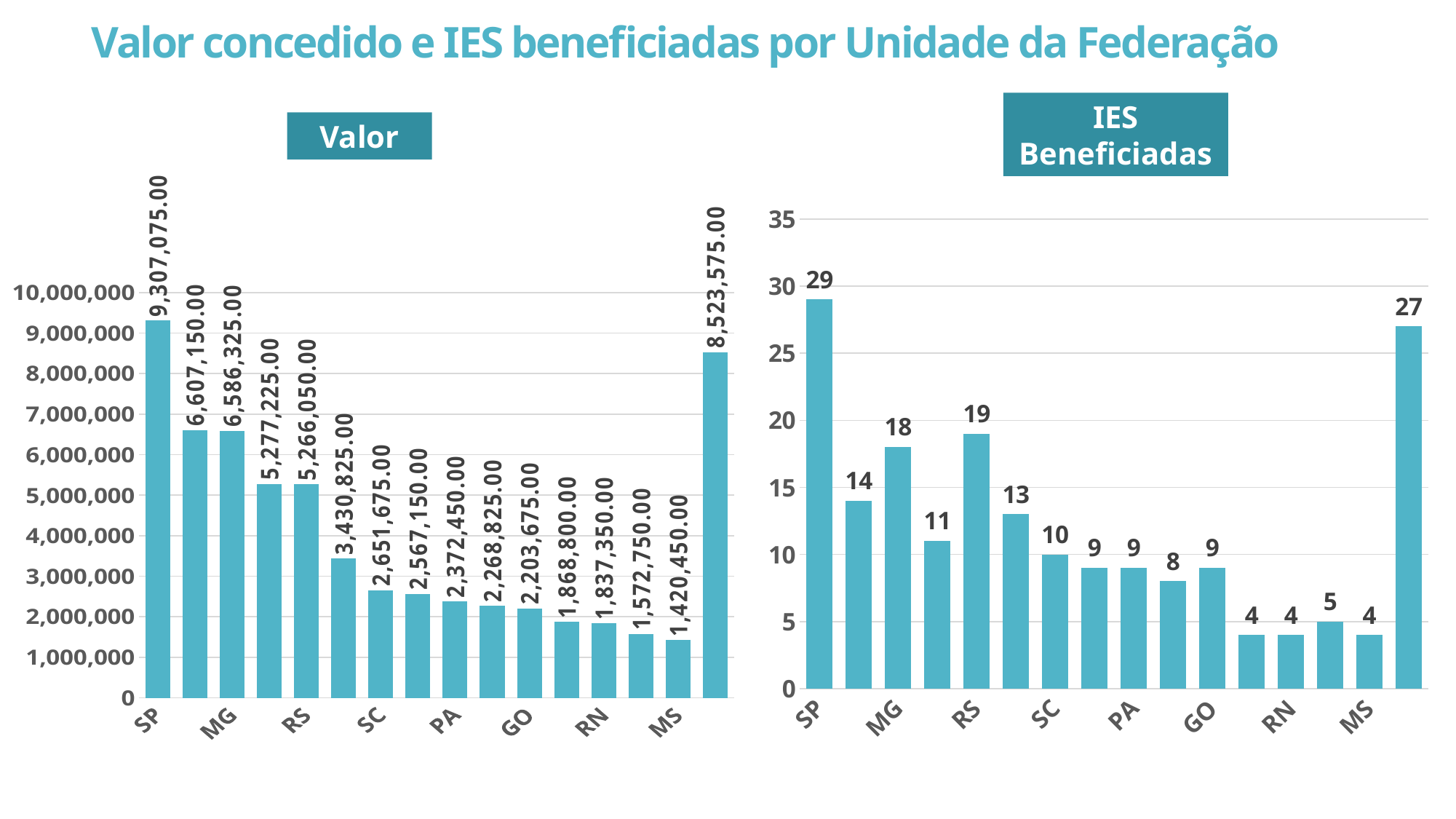
What kind of chart is the Valor chart? Bar chart On the Valor chart, what is the value for MS? 1,420,450.00 On the Valor chart, what is the value for SP? 9,307,075.00 On the IES Beneficiadas chart, which is larger, the value for RS or the value for MG? RS On the IES Beneficiadas chart, what is the value for MG? 18 On the Valor chart, which labeled state has the highest value? SP How many bars are plotted on the IES Beneficiadas chart? 16 On the Valor chart, what is the value for RS? 5,266,050.00 On the IES Beneficiadas chart, what is the difference between the values for SP and MG? 11 What is the title of the slide? Valor concedido e IES beneficiadas por Unidade da Federação On the Valor chart, which labeled state has the lowest value? MS On the IES Beneficiadas chart, what is the value for SP? 29